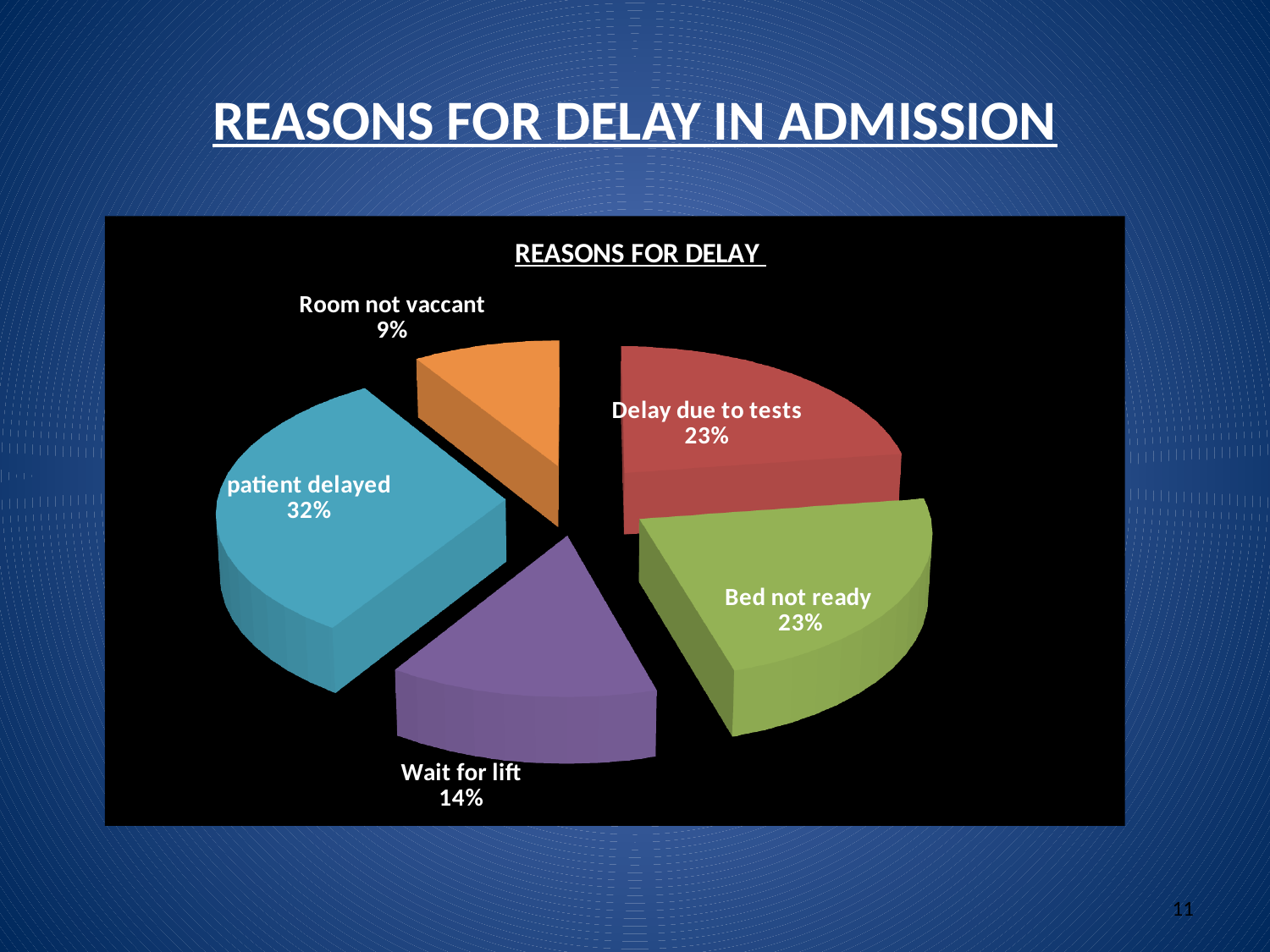
What share of the pie is 'Wait for lift'? 14% Which is larger, the share for 'Wait for lift' or the share for 'Room not vaccant'? Wait for lift Which reason has the smallest share of the pie? Room not vaccant What is the chart's title? REASONS FOR DELAY What is the difference in percentage points between 'patient delayed' and 'Wait for lift'? 18 What colour is the 'Bed not ready' slice? Green What share of the pie is 'Room not vaccant'? 9% Which reason has the largest share of the pie? patient delayed How many slices does the pie chart have? 5 What kind of chart is shown on the slide? Pie chart What share of the pie is 'patient delayed'? 32%